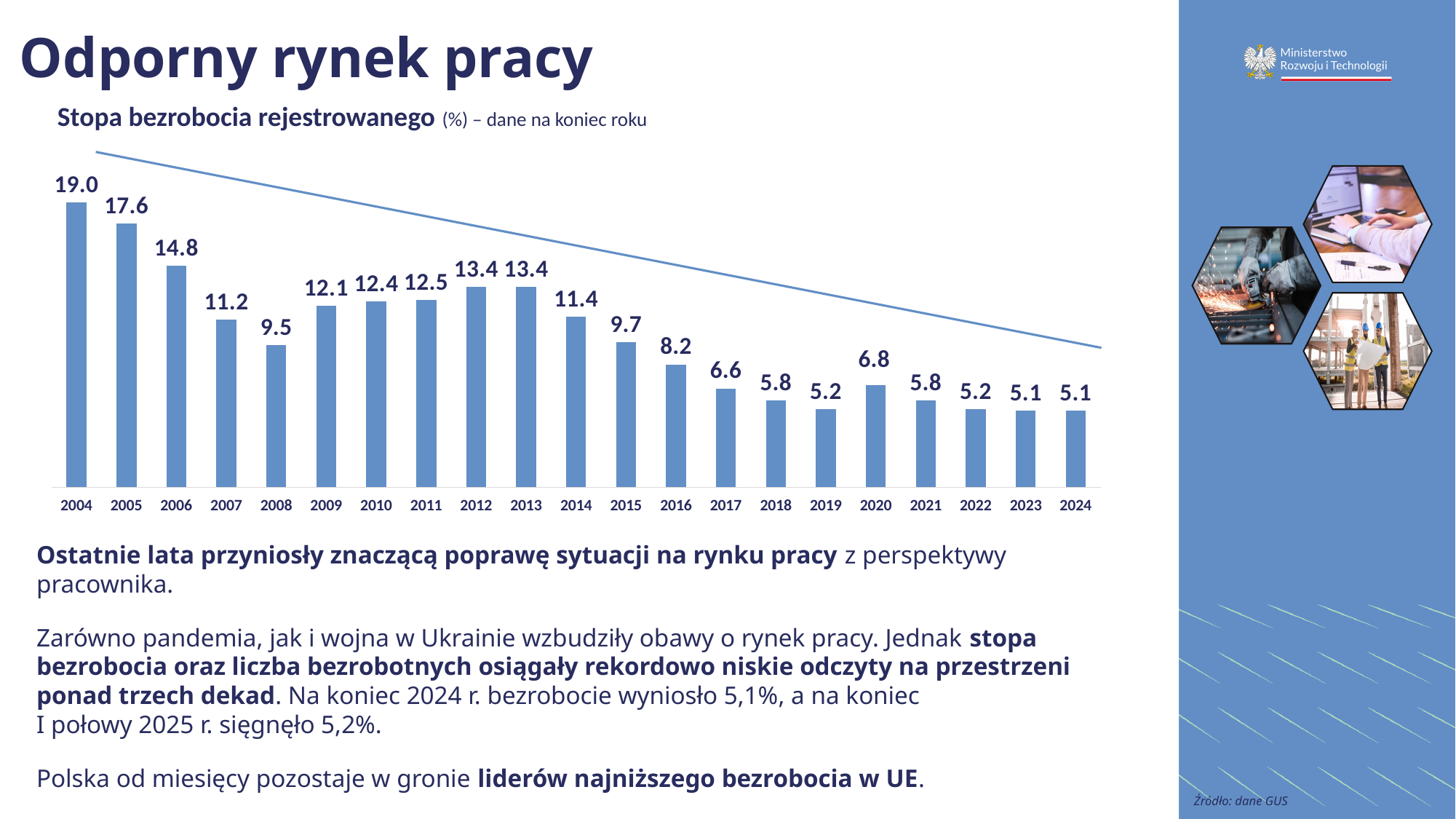
What is the difference between the values for 2004 and 2024? 13.9 Which year has a higher value, 2016 or 2017? 2016 What is the title of the chart? Stopa bezrobocia rejestrowanego (%) – dane na koniec roku What is the lowest value shown on the chart? 5.1 Overall, do the values rise or fall from 2004 to 2024? Fall What is the registered unemployment rate shown for 2004? 19.0 What is the value plotted for 2013? 13.4 What value does the chart show for 2020? 6.8 How many years are shown on the x axis of the chart? 21 What kind of chart is used on the slide? Bar chart Which year has the highest registered unemployment rate on the chart? 2004 What is the difference between the values for 2008 and 2009? 2.6